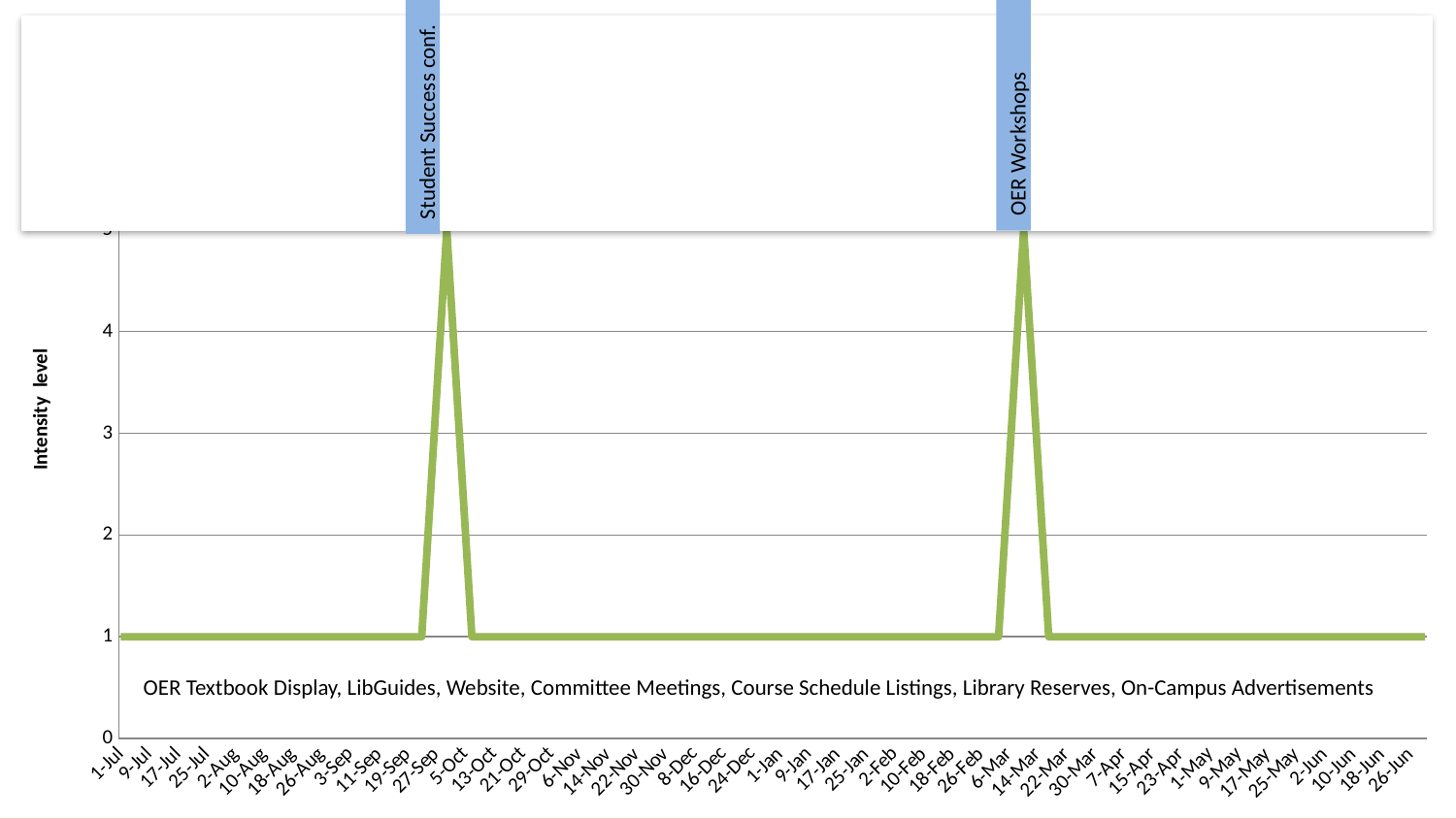
What is the intensity level on 1-Jan? 1 Between 13-Oct and 26-Feb, does the line rise, fall, or stay flat? stay flat Is the intensity level on 8-Dec greater or less than 2? less What is the title of the vertical axis? Intensity level Is the peak of the spike labeled 'Student Success conf.' greater or less than 4? greater Which is larger: the intensity level at the peak labeled 'OER Workshops' or the intensity level on 26-Jun? the peak labeled OER Workshops Which event label is attached to the spike in March? OER Workshops What is the first date shown on the x axis? 1-Jul What is the intensity level on 1-Jul? 1 How many spikes above the baseline does the line show? 2 What kind of chart is shown on the slide? line chart What is the lowest intensity level the line reaches? 1